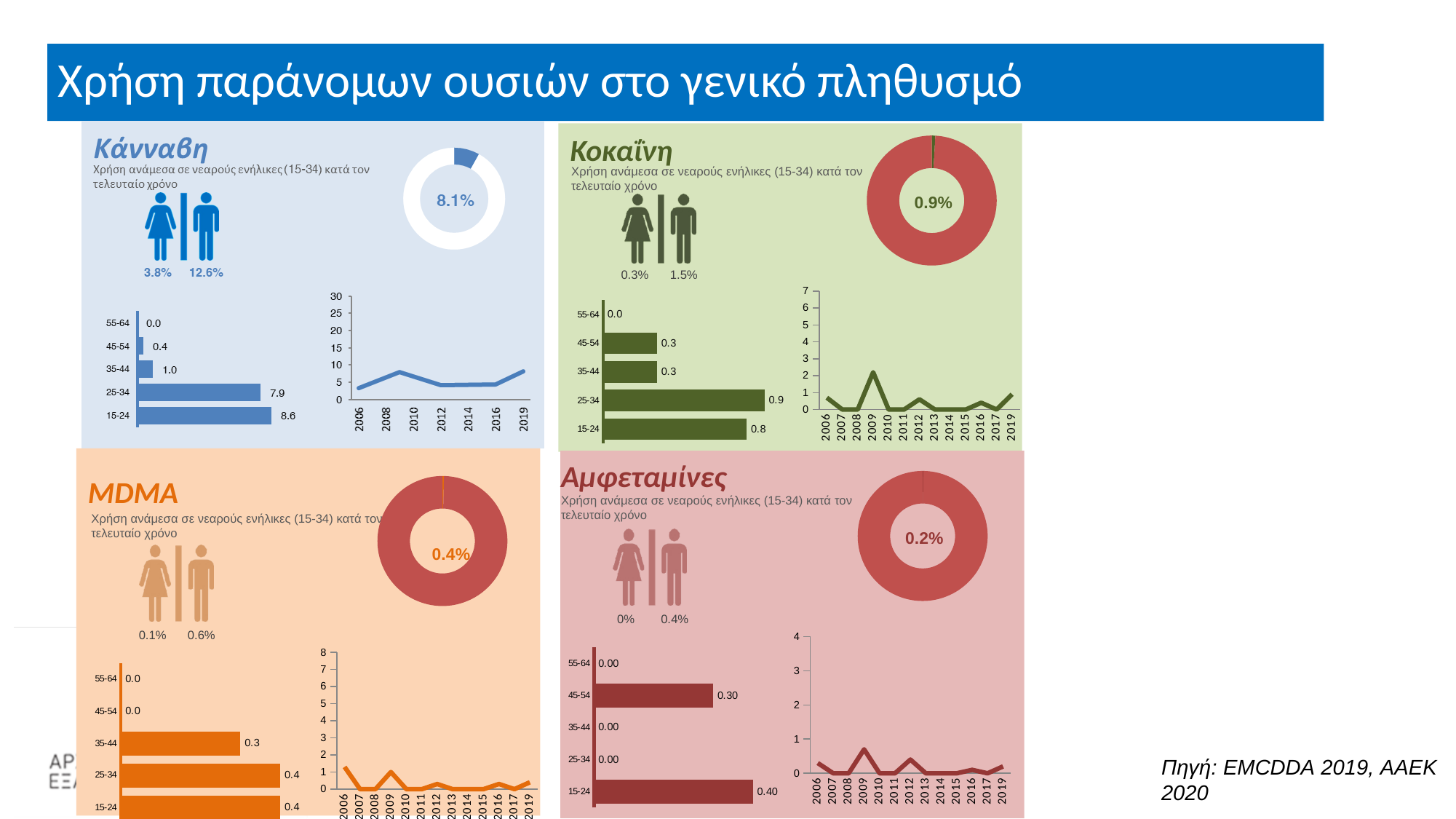
In the MDMA panel, what percentage is shown in the centre of the donut chart? 0.4% In the MDMA panel, what is the value shown for the 35-44 age group in the bar chart? 0.3 In the Κάνναβη panel, what is the difference between the values for the 15-24 and 25-34 age groups? 0.7 In the Κάνναβη panel, what is the value shown for the 15-24 age group in the bar chart? 8.6 In the Κάνναβη panel, how many age groups are shown in the bar chart? 5 In the Κάνναβη panel, which age group has the highest value in the bar chart? 15-24 In the Κοκαΐνη panel, what is the value shown for the 25-34 age group in the bar chart? 0.9 In the Κοκαΐνη panel, is the value for 2009 in the line chart greater or less than 1? greater In the Αμφεταμίνες panel, which age group has the highest value in the bar chart? 15-24 What kind of chart shows the values by age group in the Κάνναβη panel? bar chart In the Αμφεταμίνες panel, what is the value shown for the 45-54 age group in the bar chart? 0.30 In the Κοκαΐνη panel, which is larger in the bar chart: the value for 25-34 or for 15-24? 25-34